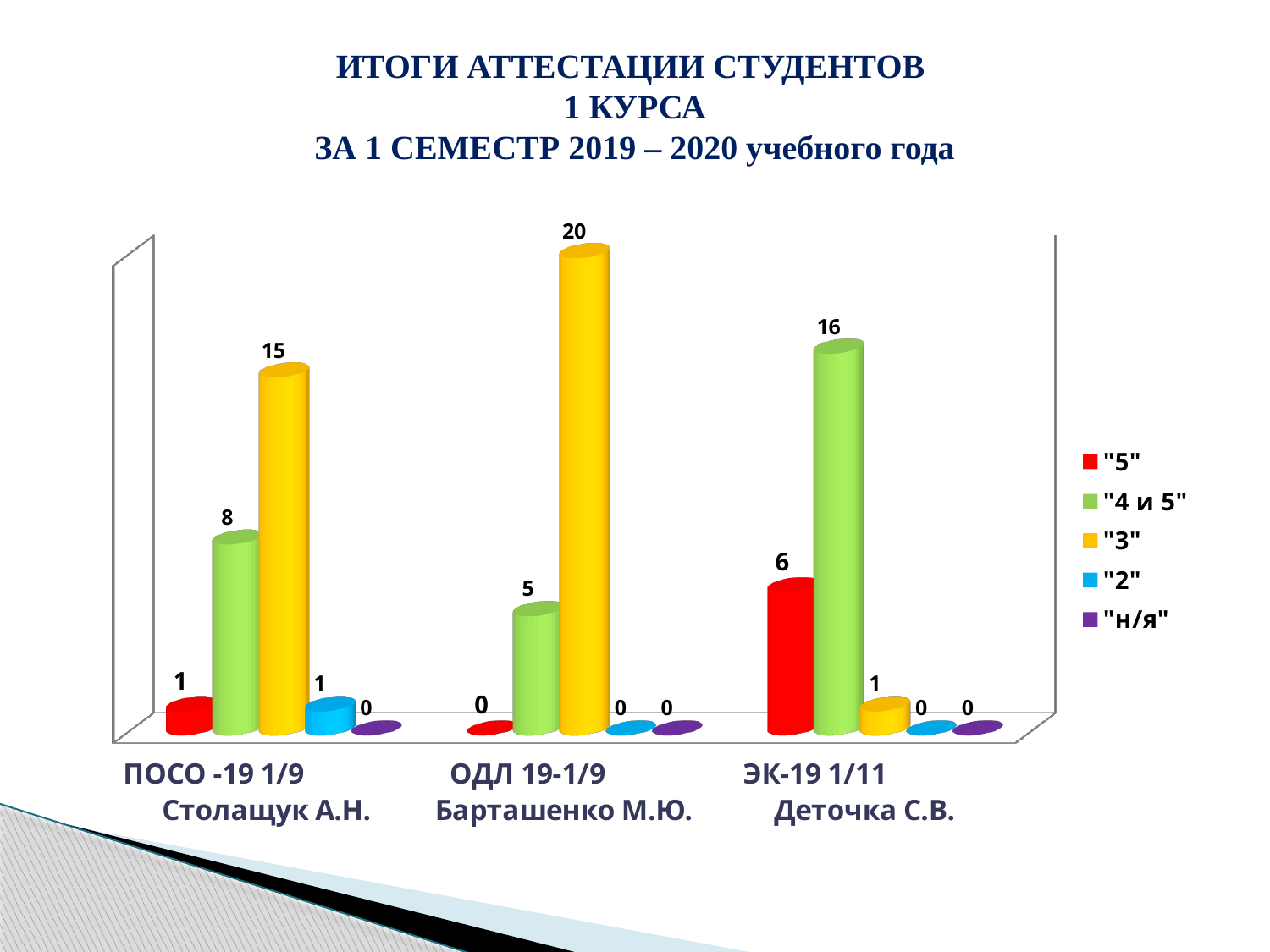
What is the difference between the "3" values for ОДЛ 19-1/9 and ПОСО -19 1/9? 5 What is the value for "5" in the ПОСО -19 1/9 group? 1 What colour represents the "н/я" series in the legend? Purple What is the value for "3" in the ОДЛ 19-1/9 group? 20 Which group has the lowest value for "4 и 5"? ОДЛ 19-1/9 What is the value for "4 и 5" in the ЭК-19 1/11 group? 16 Which group has the highest value for "3"? ОДЛ 19-1/9 How many series does the legend list? 5 Which is larger: the "5" value for ЭК-19 1/11 or the "4 и 5" value for ОДЛ 19-1/9? "5" value for ЭК-19 1/11 What is the value for "2" in the ПОСО -19 1/9 group? 1 What kind of chart is shown on the slide? Bar chart How many groups (categories) are shown on the x axis? 3